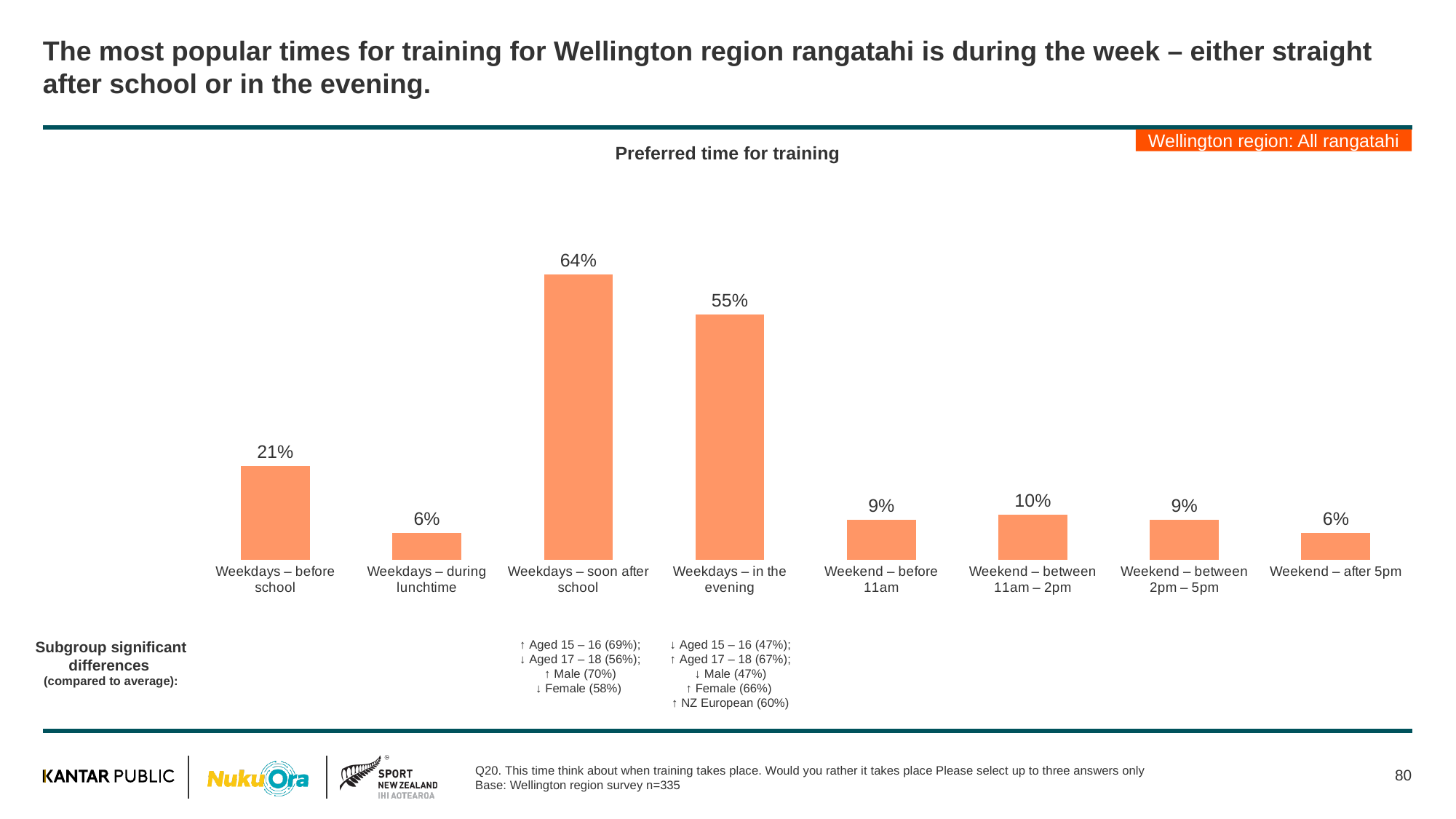
What is the value for 'Weekend – between 11am – 2pm'? 10% How many categories are shown in the chart? 8 Which is larger, 'Weekdays – before school' or 'Weekend – between 11am – 2pm'? Weekdays – before school What is the value for 'Weekdays – in the evening'? 55% What is the title of the chart? Preferred time for training Which two categories share the lowest value of 6%? Weekdays – during lunchtime and Weekend – after 5pm What is the value for 'Weekdays – before school'? 21% What is the value for 'Weekdays – soon after school'? 64% Which category has the highest value? Weekdays – soon after school What is the difference between 'Weekdays – soon after school' and 'Weekdays – in the evening'? 9% What is the difference between 'Weekdays – before school' and 'Weekend – before 11am'? 12% What kind of chart is shown on the slide? Bar chart